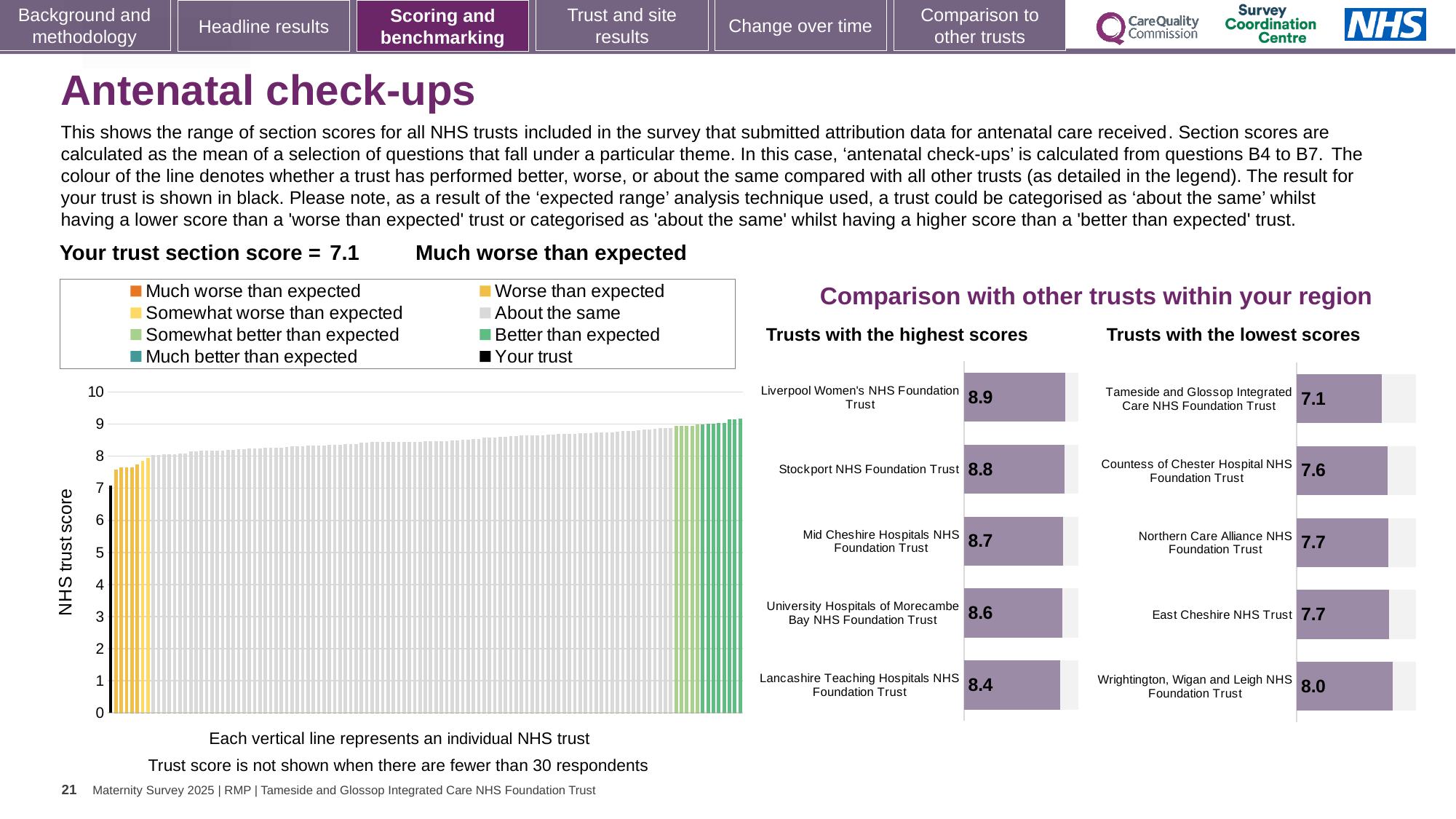
In the 'Trusts with the highest scores' chart, which has the higher score: Stockport NHS Foundation Trust or Mid Cheshire Hospitals NHS Foundation Trust? Stockport NHS Foundation Trust In the 'Trusts with the lowest scores' chart, what is the score for Countess of Chester Hospital NHS Foundation Trust? 7.6 How many trusts are listed in the 'Trusts with the highest scores' chart? 5 In the 'Trusts with the highest scores' chart, what is the score for Liverpool Women's NHS Foundation Trust? 8.9 In the 'Trusts with the lowest scores' chart, what is the score for Wrightington, Wigan and Leigh NHS Foundation Trust? 8.0 In the 'Trusts with the highest scores' chart, which trust has the highest score? Liverpool Women's NHS Foundation Trust In the 'Trusts with the lowest scores' chart, what is the difference between the scores of Wrightington, Wigan and Leigh NHS Foundation Trust and Tameside and Glossop Integrated Care NHS Foundation Trust? 0.9 In the 'Trusts with the highest scores' chart, what is the difference between the scores of Liverpool Women's NHS Foundation Trust and Lancashire Teaching Hospitals NHS Foundation Trust? 0.5 In the 'Trusts with the lowest scores' chart, which trust has the lowest score? Tameside and Glossop Integrated Care NHS Foundation Trust What kind of chart is the 'NHS trust score' chart on the left of the slide? Bar chart In the 'NHS trust score' chart on the left, do the trust scores rise or fall from left to right? Rise In the 'Trusts with the highest scores' chart, what is the score for Lancashire Teaching Hospitals NHS Foundation Trust? 8.4